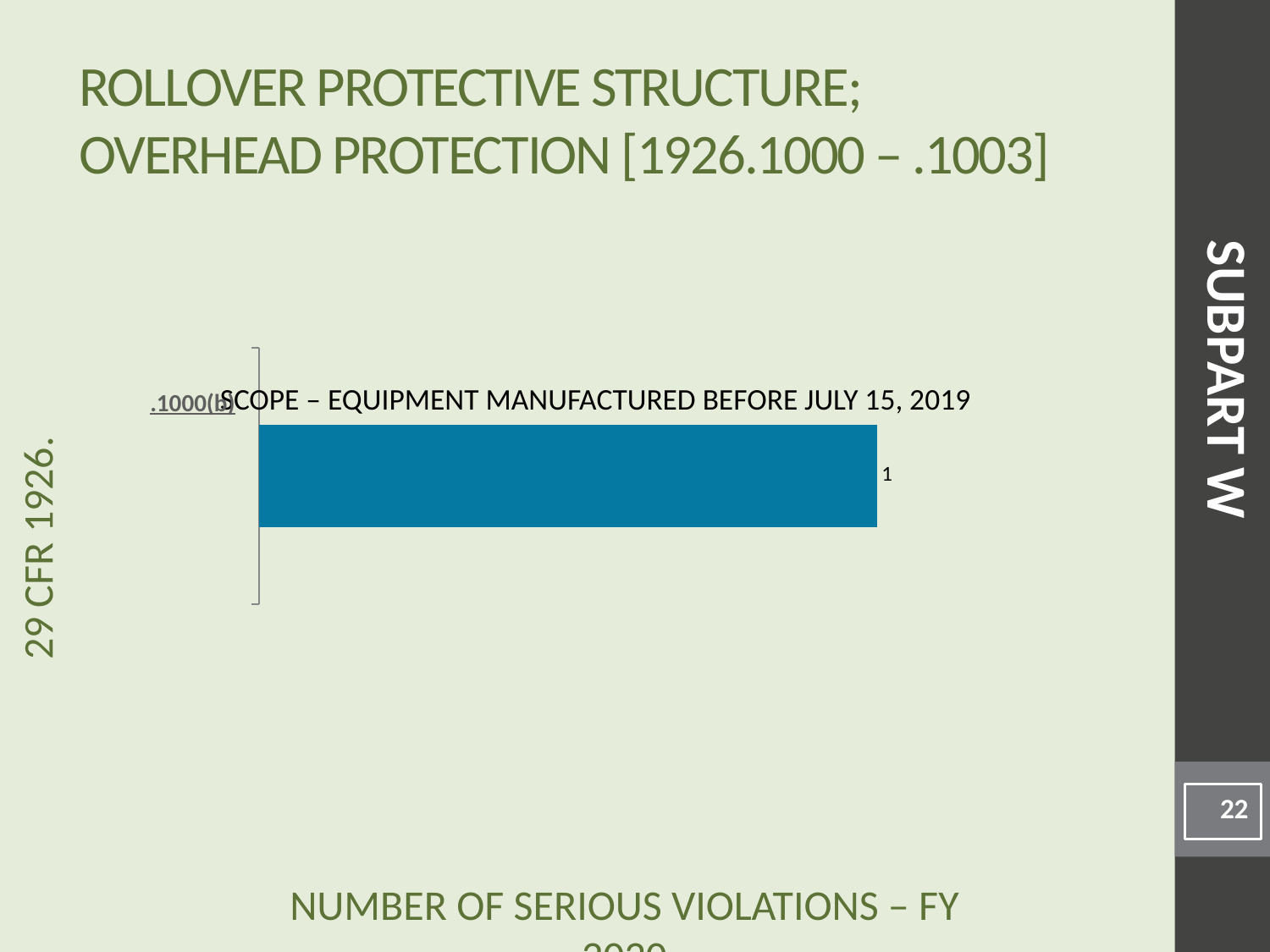
What is the number of serious violations for the category labelled SCOPE – EQUIPMENT MANUFACTURED BEFORE JULY 15, 2019? 1 What is the total of all values plotted in the chart? 1 Which standard paragraph is the single bar in the chart labelled with? .1000(b) What kind of chart is shown on the slide? bar chart What is the value of the bar for .1000(b)? 1 How many bars does the chart show? 1 Are the bars in the chart horizontal or vertical? horizontal